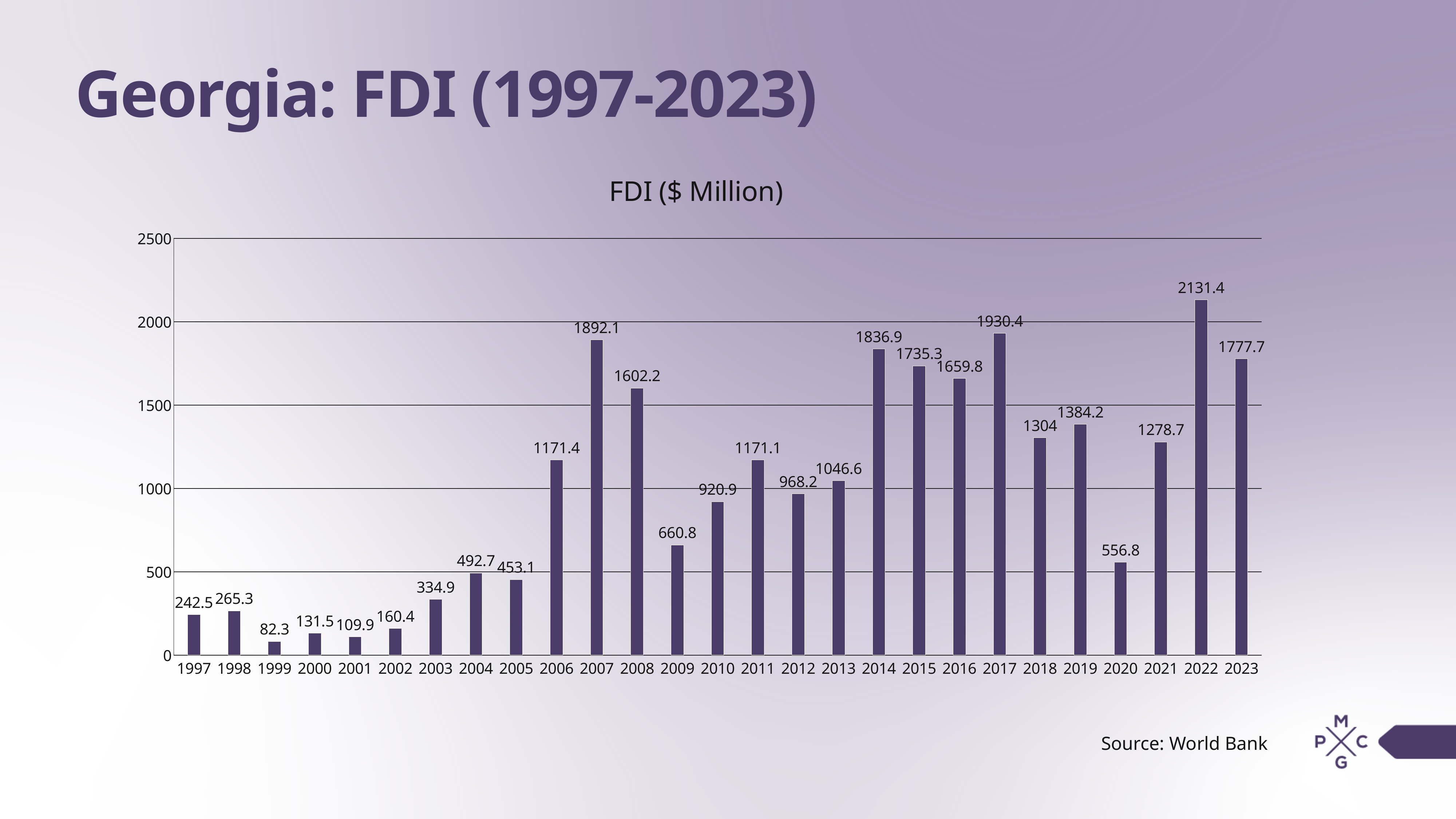
What is the FDI value for 2020? 556.8 What is the FDI value for 2018? 1304 What type of chart is shown on the slide? bar chart How many years are shown on the x axis? 27 What is the difference between the FDI values for 2021 and 2020? 721.9 What is the difference between the FDI values for 2022 and 2023? 353.7 Which year has the lowest FDI value? 1999 Which year has the highest FDI value? 2022 Which year has a larger FDI value, 2014 or 2015? 2014 Is the FDI value for 2009 greater or less than 1000? less What is the FDI value for 2007? 1892.1 Do the FDI values rise or fall from 2020 to 2022? rise